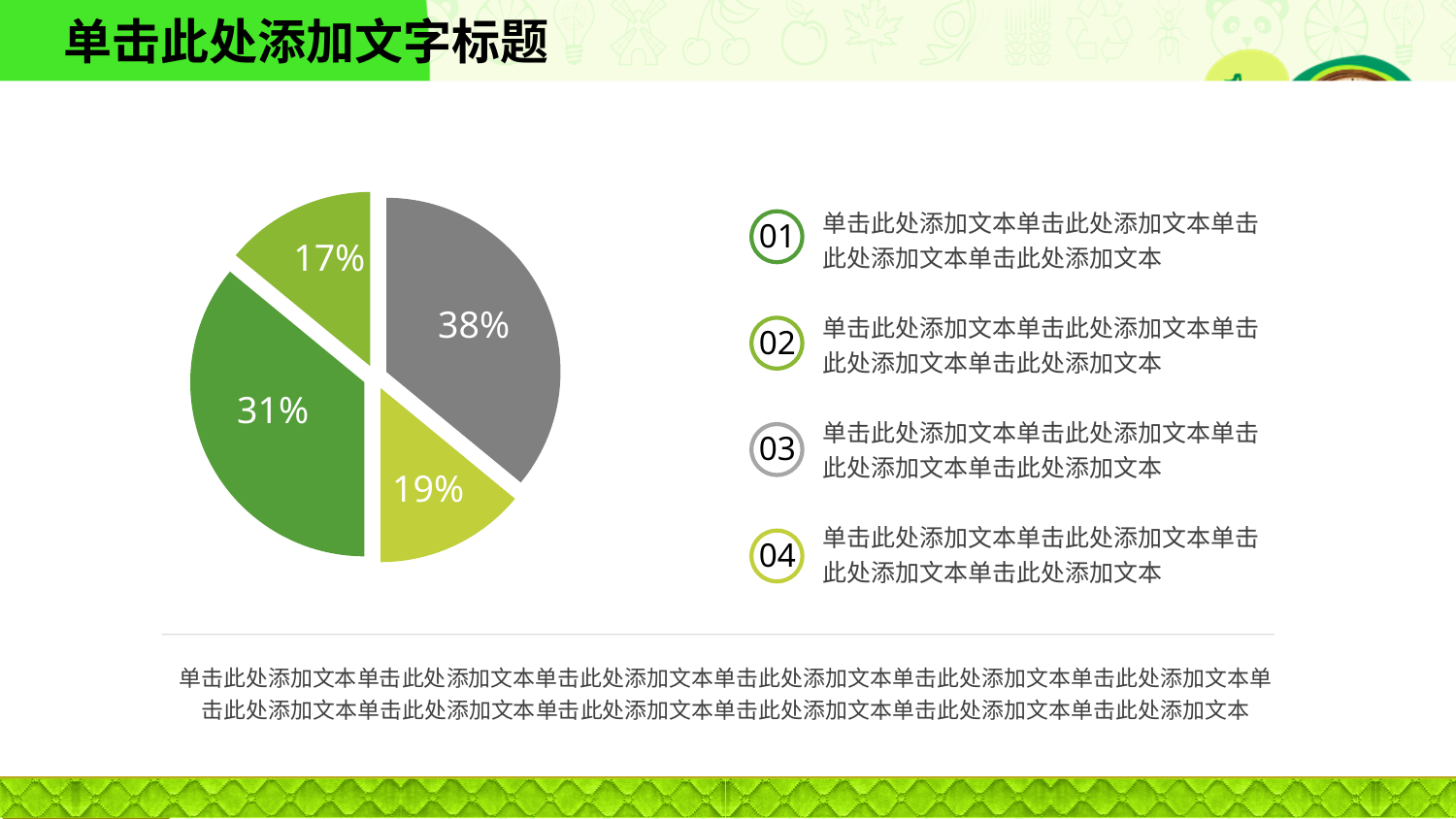
Which slice of the pie chart has the smallest percentage? the light green slice (17%) What is the difference between the 19% slice and the 17% slice in the pie chart? 2% What percentage is shown on the yellow-green slice at the bottom of the pie chart? 19% What is the difference between the gray slice and the dark green slice in the pie chart? 7% Which is larger in the pie chart, the 19% slice or the 17% slice? the 19% slice Does the pie chart have a legend? No What percentage is shown on the dark green slice of the pie chart? 31% Which slice of the pie chart has the largest percentage? the gray slice (38%) What percentage is shown on the gray slice of the pie chart? 38% What percentage is shown on the light green slice at the top left of the pie chart? 17% What kind of chart is shown on the slide? pie chart How many slices does the pie chart have? 4